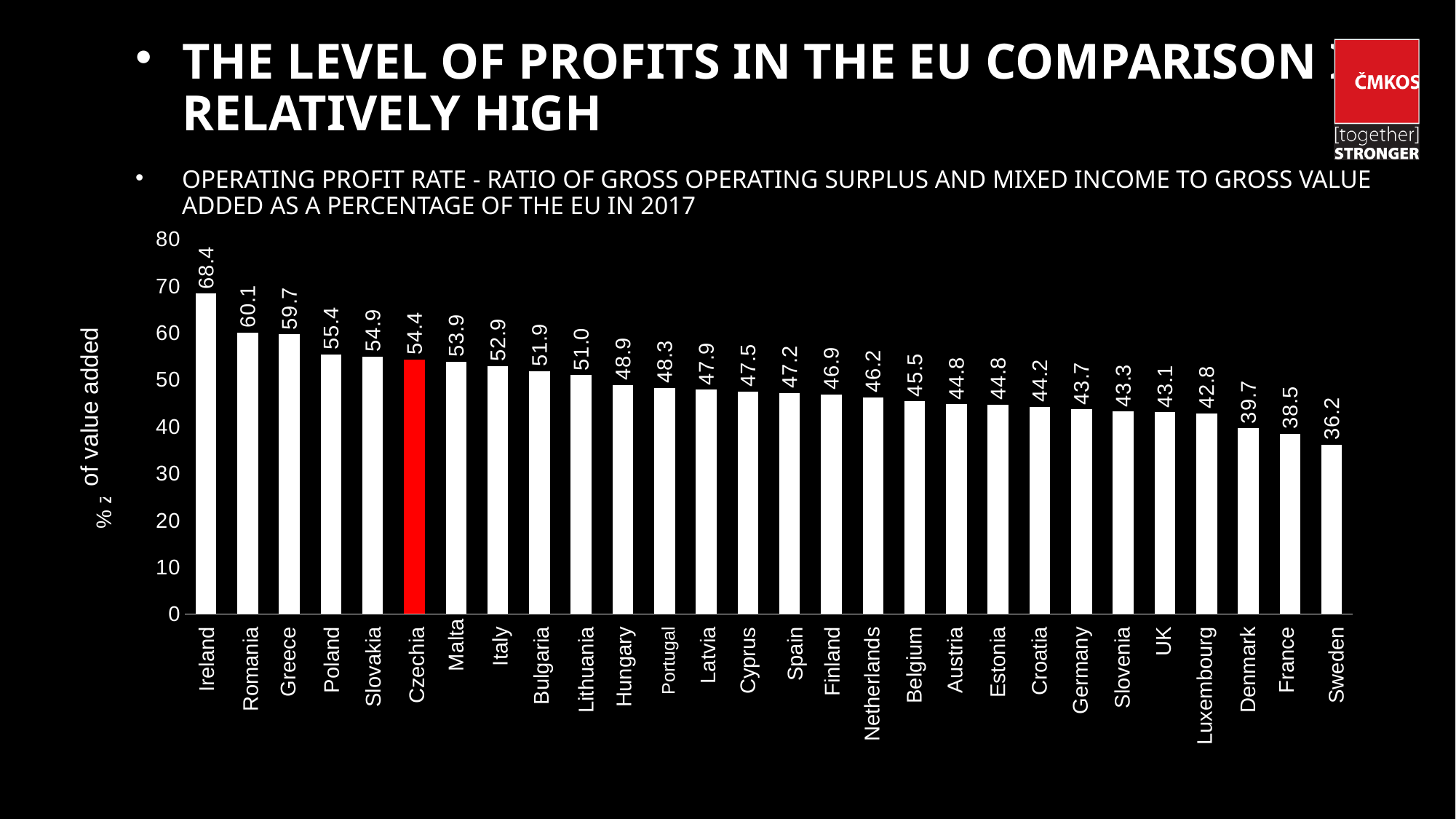
Which country's bar is highlighted in red? Czechia Which has a larger value, Poland or Hungary? Poland What is the value for Sweden? 36.2 What is the value for Germany? 43.7 Which country has the lowest value? Sweden What is the difference between the values for Ireland and Czechia? 14.0 Is the value for Denmark greater or less than 40? less Which country has the highest value? Ireland What kind of chart is shown on the slide? bar chart What is the value for Czechia? 54.4 Do the values rise or fall from left to right along the x axis? fall How many countries are shown in the chart? 28